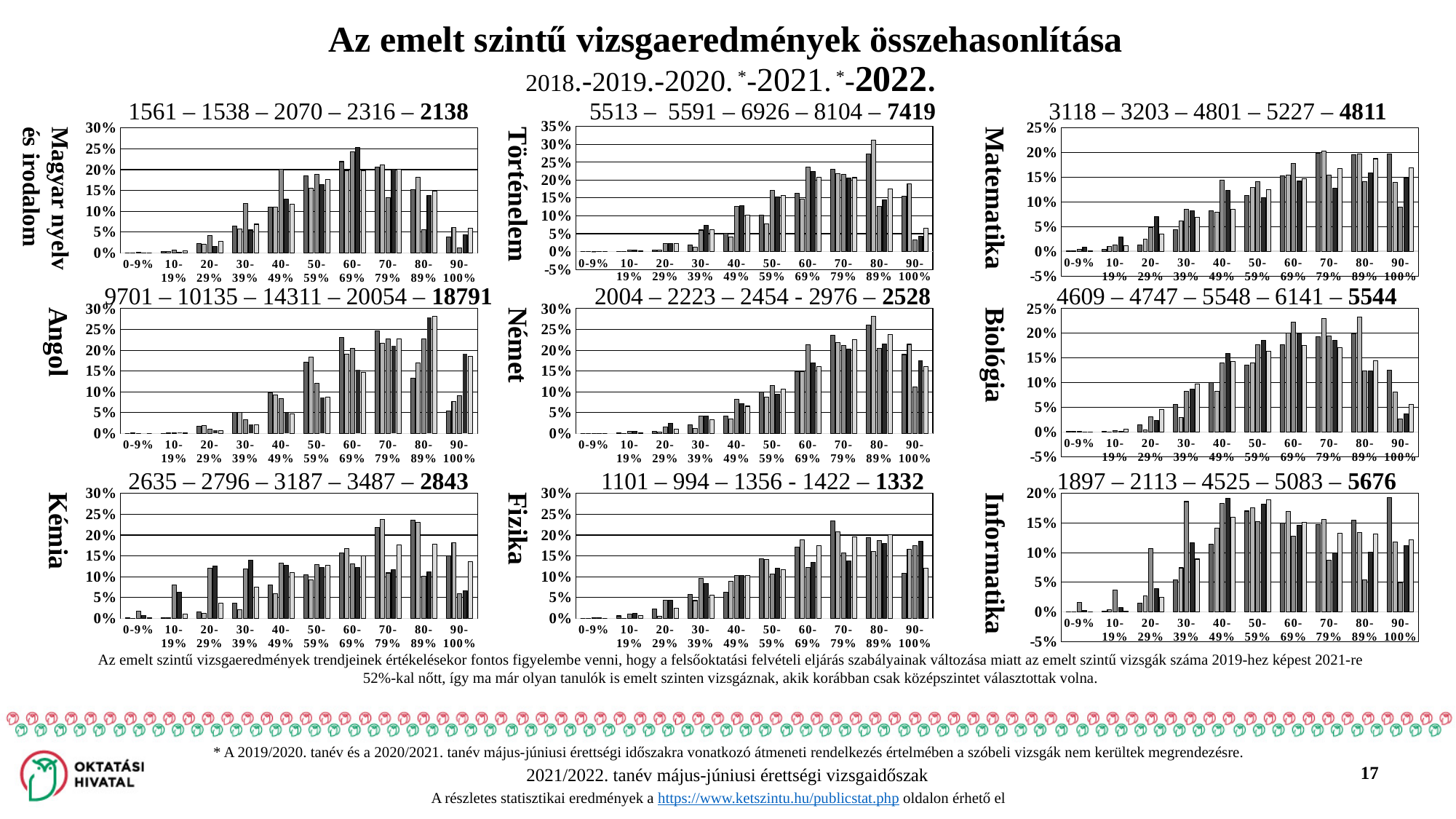
What kind of chart is the Matematika chart? bar chart In the Történelem chart, which score band contains the tallest bar? 80-89% In the Biológia chart, is the tallest bar in the 80-89% band greater or less than 20%? greater In the Informatika chart, is the tallest bar in the 40-49% band greater or less than 15%? greater In the Német chart, which score band contains the tallest bar? 80-89% How many score bands are shown on the x axis of the Angol chart? 10 In the Történelem chart, are the bars in the 0-9% band greater or less than 5%? less In the Matematika chart, do the bars generally rise or fall from the 0-9% band to the 60-69% band? rise What is the title of the slide above the charts? Az emelt szintű vizsgaeredmények összehasonlítása What is the bold final number printed above the Informatika chart? 5676